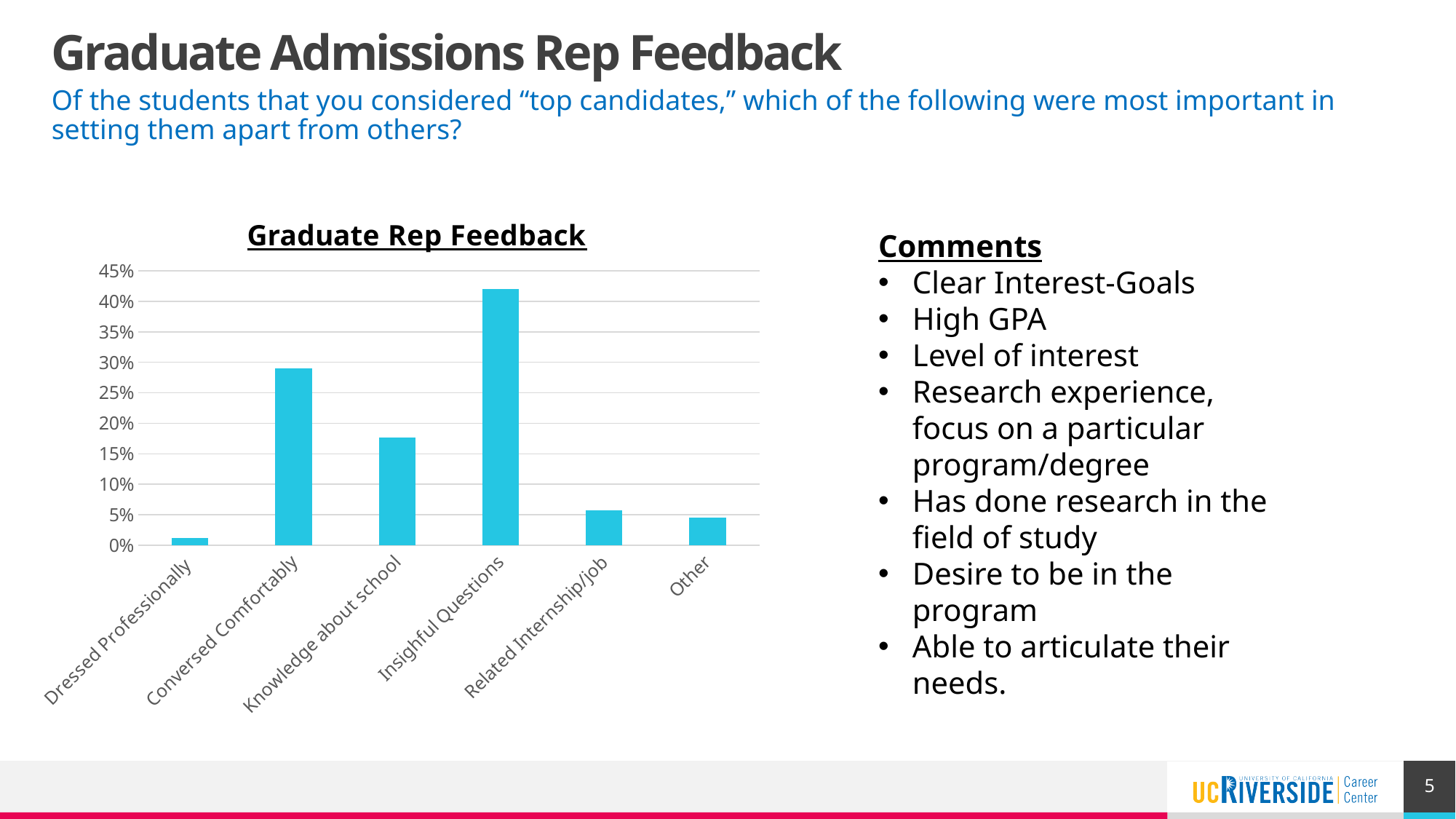
Which category has the lowest value in the chart? Dressed Professionally Is the value for Knowledge about school greater or less than 15%? greater How many categories are shown on the x axis of the chart? 6 Which has a larger value, Conversed Comfortably or Knowledge about school? Conversed Comfortably Which category has the highest value in the chart? Insighful Questions Which has a larger value, Insightful Questions or Conversed Comfortably? Insighful Questions What is the title of the chart? Graduate Rep Feedback What is the highest value shown on the y axis of the chart? 45% Is the value for Insightful Questions greater or less than 40%? greater Is the value for Dressed Professionally greater or less than 5%? less What kind of chart is shown on the slide? Bar chart